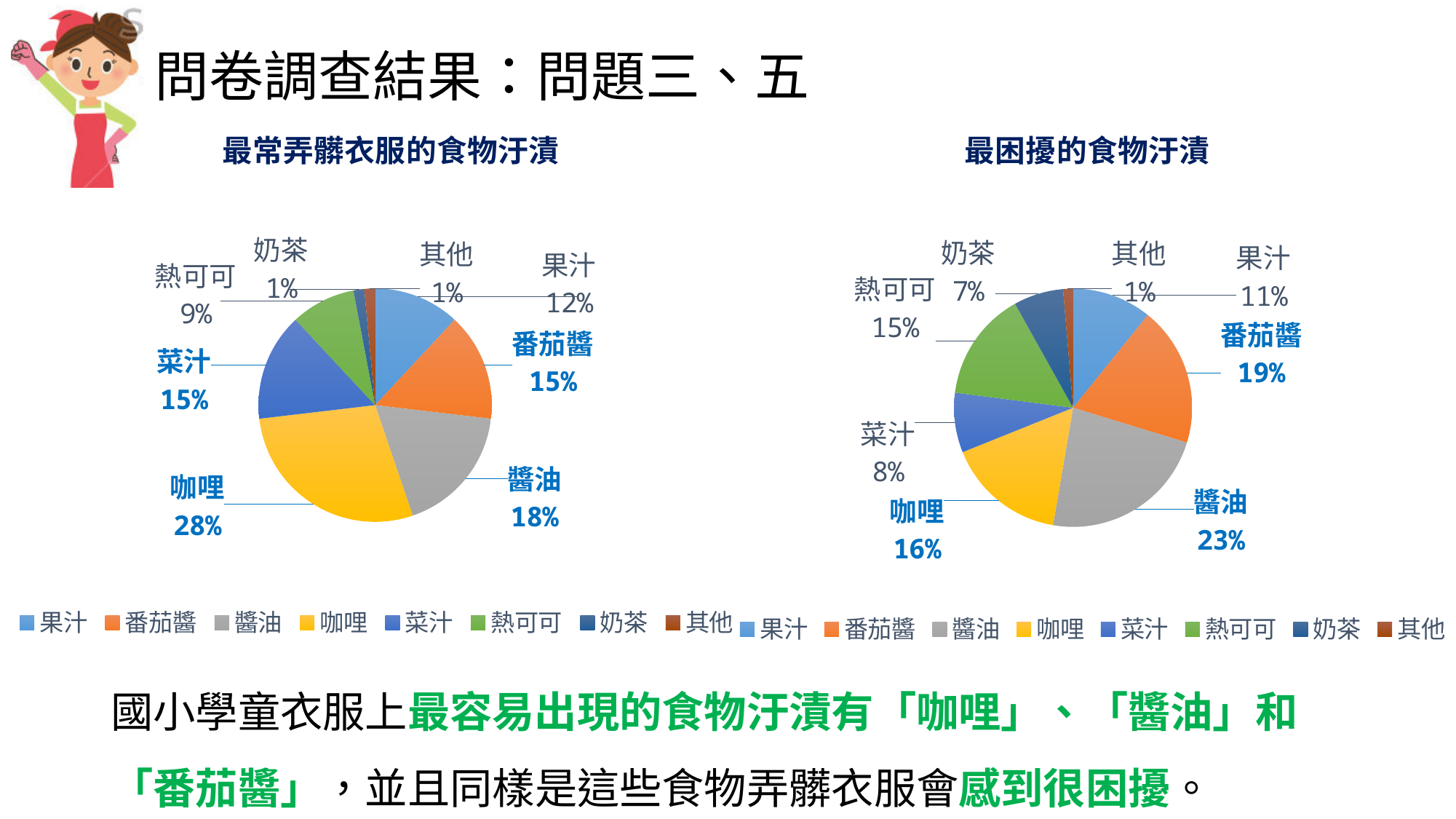
What kind of chart is the chart titled 最困擾的食物汙漬? Pie chart How many categories does the chart titled 最常弄髒衣服的食物汙漬 show? 8 In the chart titled 最困擾的食物汙漬, what is the difference between the shares of 番茄醬 and 咖哩? 3% In the chart titled 最困擾的食物汙漬, what share does 醬油 have? 23% In the chart titled 最常弄髒衣服的食物汙漬, which is larger, 果汁 or 熱可可? 果汁 In the chart titled 最常弄髒衣服的食物汙漬, what share does 熱可可 have? 9% In the chart titled 最困擾的食物汙漬, which category has the largest slice? 醬油 In the chart titled 最常弄髒衣服的食物汙漬, which category has the largest slice? 咖哩 In the chart titled 最困擾的食物汙漬, which is larger, 熱可可 or 菜汁? 熱可可 In the chart titled 最困擾的食物汙漬, which category has the smallest slice? 其他 In the chart titled 最常弄髒衣服的食物汙漬, what share does 咖哩 have? 28% In the chart titled 最常弄髒衣服的食物汙漬, what is the difference between the shares of 咖哩 and 醬油? 10%